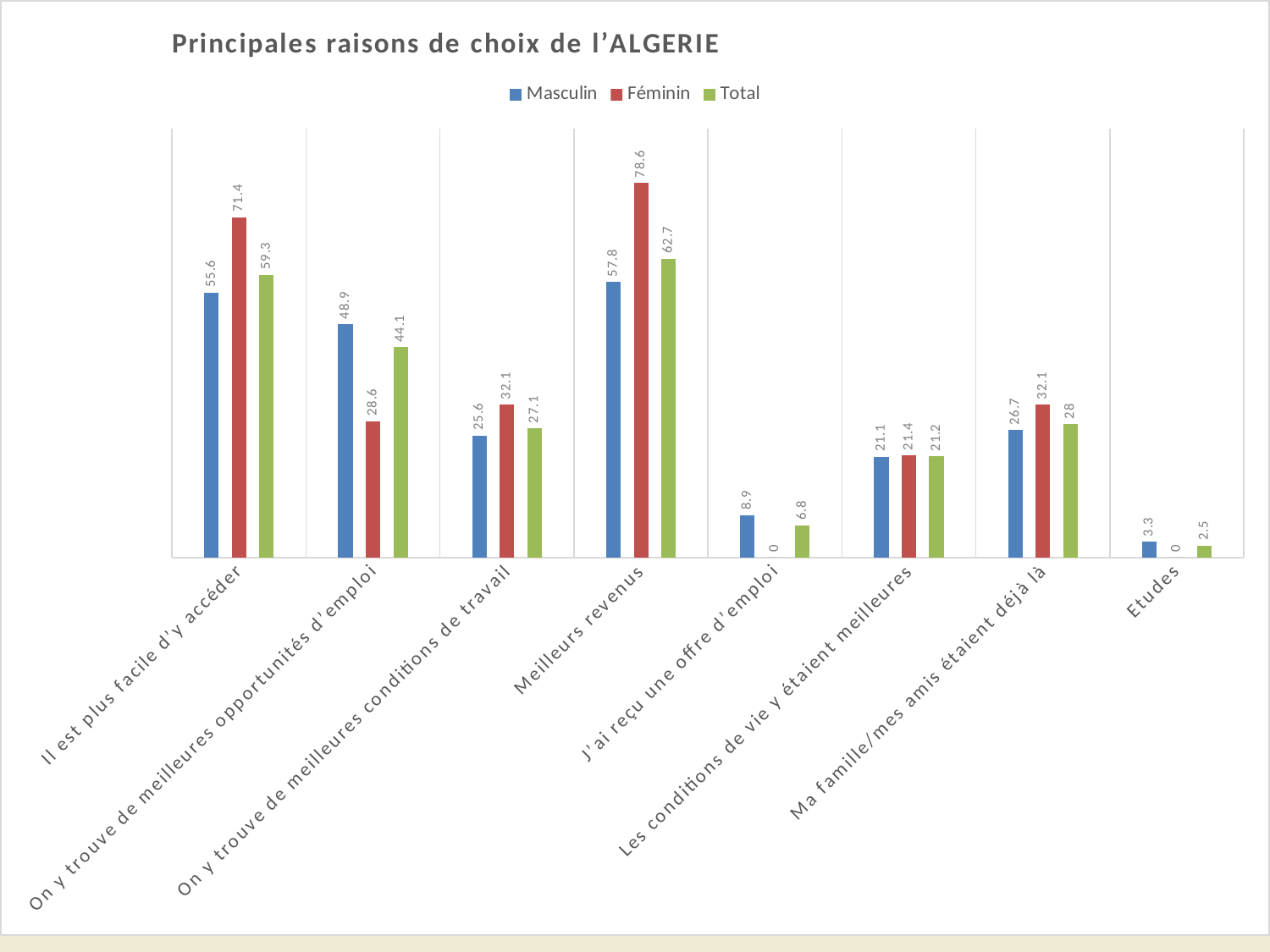
What is the Féminin value for "Meilleurs revenus"? 78.6 Which category has the highest Total value? Meilleurs revenus What kind of chart is shown on the slide? Bar chart What is the Masculin value for "On y trouve de meilleures opportunités d'emploi"? 48.9 Which category has the lowest Masculin value? Etudes How many categories are shown on the x axis? 8 What is the difference between the Féminin and Masculin values for "Il est plus facile d'y accéder"? 15.8 What is the Féminin value for "J'ai reçu une offre d'emploi"? 0 What is the title of the chart? Principales raisons de choix de l'ALGERIE For "On y trouve de meilleures opportunités d'emploi", which is larger: the Masculin value or the Féminin value? Masculin How many series does the legend list? 3 What is the Total value for "Il est plus facile d'y accéder"? 59.3